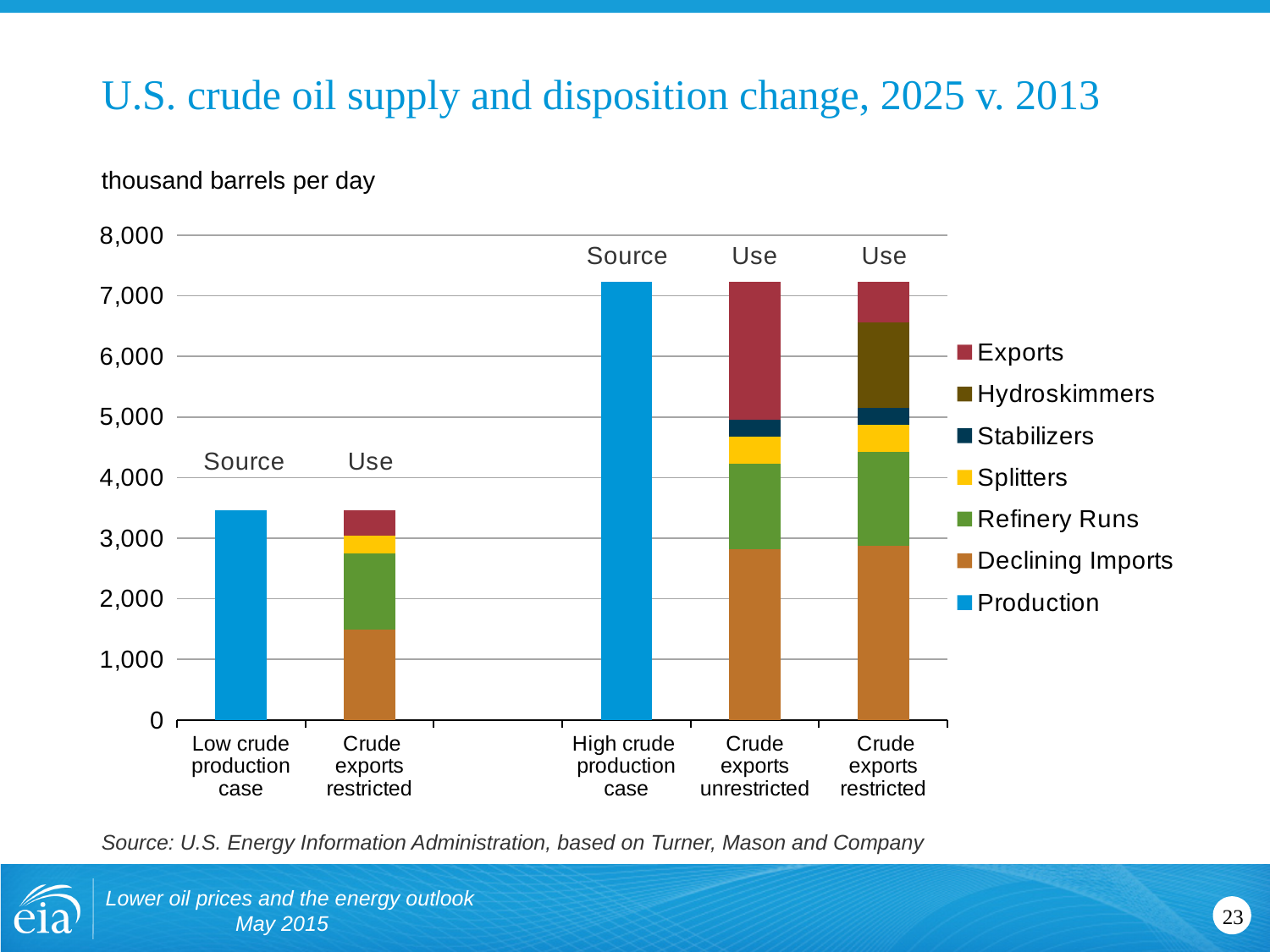
Is the total of the Crude exports unrestricted bar greater or less than 6,000? greater Which bar has the larger Exports segment: Crude exports unrestricted or Crude exports restricted in the high crude production case? Crude exports unrestricted How many bars are plotted in the chart? 5 How many series does the legend list? 7 Is the value for the Low crude production case bar greater or less than 3,000? greater Is the value for the High crude production case bar greater or less than 6,000? greater Which bar is taller: High crude production case or Low crude production case? High crude production case What kind of chart is shown on the slide? bar chart What is the title of the chart? U.S. crude oil supply and disposition change, 2025 v. 2013 What unit is given for the values on the y axis? thousand barrels per day